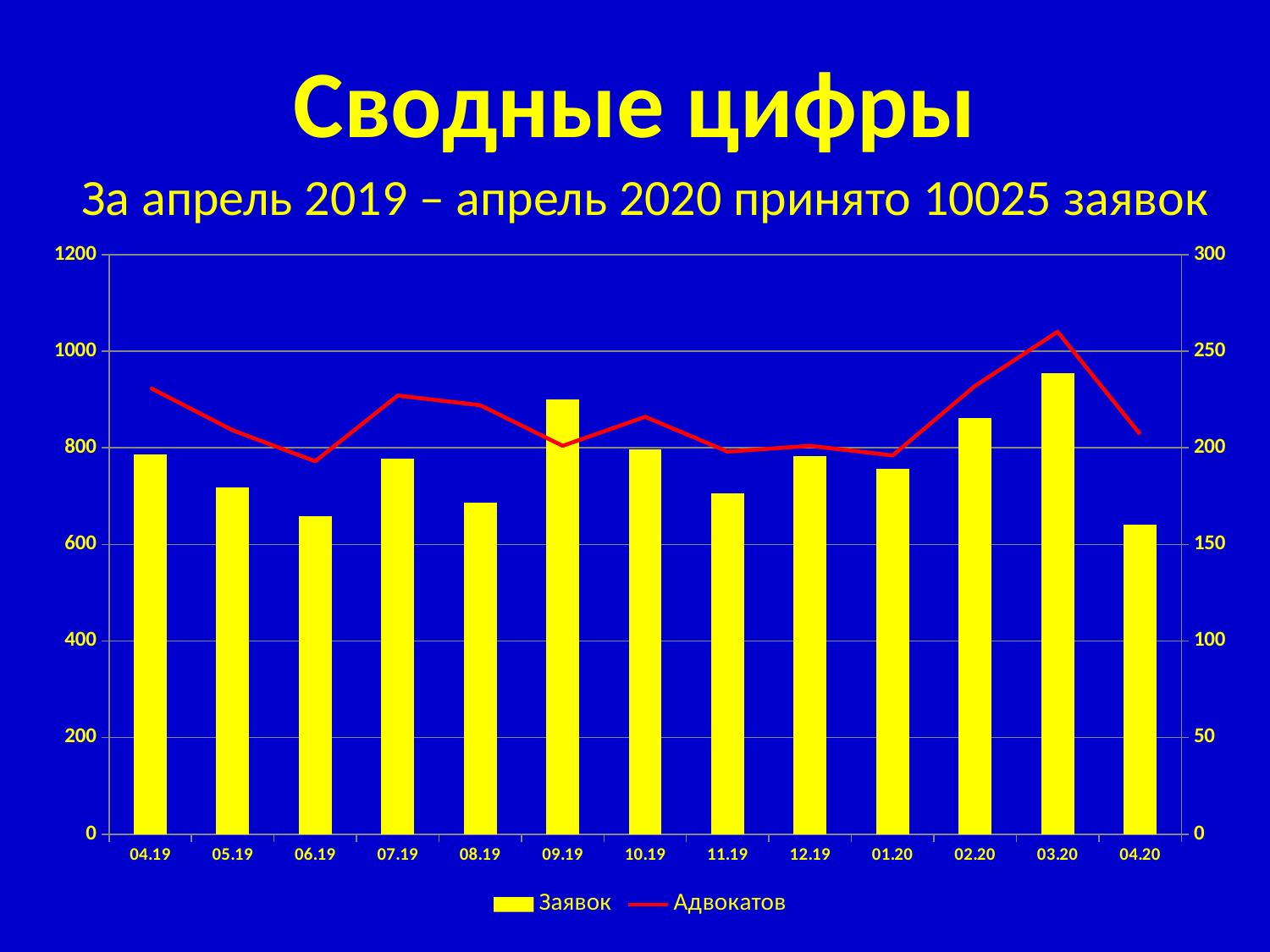
Is the Адвокатов value for 04.19 greater or less than 200? greater Which has the larger Заявок value, 03.20 or 04.20? 03.20 How many series does the legend list? 2 How many months are shown on the x axis? 13 Is the Заявок value for 04.20 greater or less than 800? less What are the two series named in the legend? Заявок and Адвокатов Do the Заявок values rise or fall from 01.20 to 03.20? rise Is the Адвокатов value for 03.20 greater or less than 250? greater Which has the larger Заявок value, 09.19 or 05.19? 09.19 Which month has the highest value for Адвокатов? 03.20 Which month has the highest value for Заявок? 03.20